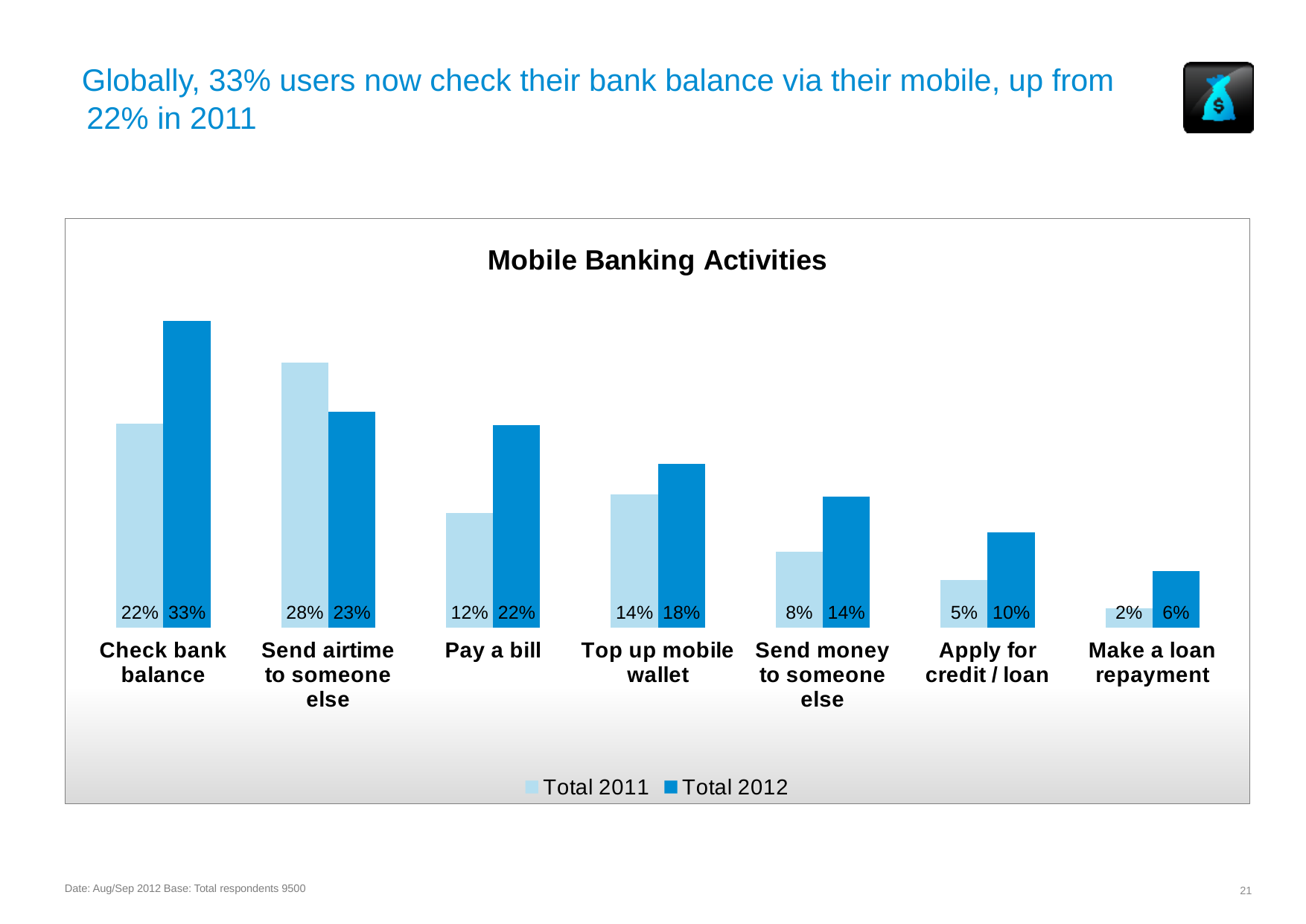
What is the difference between the Total 2012 and Total 2011 values for Send money to someone else? 6% What is the Total 2012 value for Check bank balance? 33% Which activity has the highest Total 2012 value? Check bank balance What is the Total 2011 value for Send airtime to someone else? 28% What is the Total 2012 value for Pay a bill? 22% What kind of chart is shown on the slide? Bar chart How many series does the legend list? 2 How many activities are shown on the chart? 7 Which is larger for Send airtime to someone else: the Total 2011 value or the Total 2012 value? Total 2011 What is the difference between the Total 2012 and Total 2011 values for Check bank balance? 11% Which activity has the lowest Total 2011 value? Make a loan repayment What is the title of the chart? Mobile Banking Activities